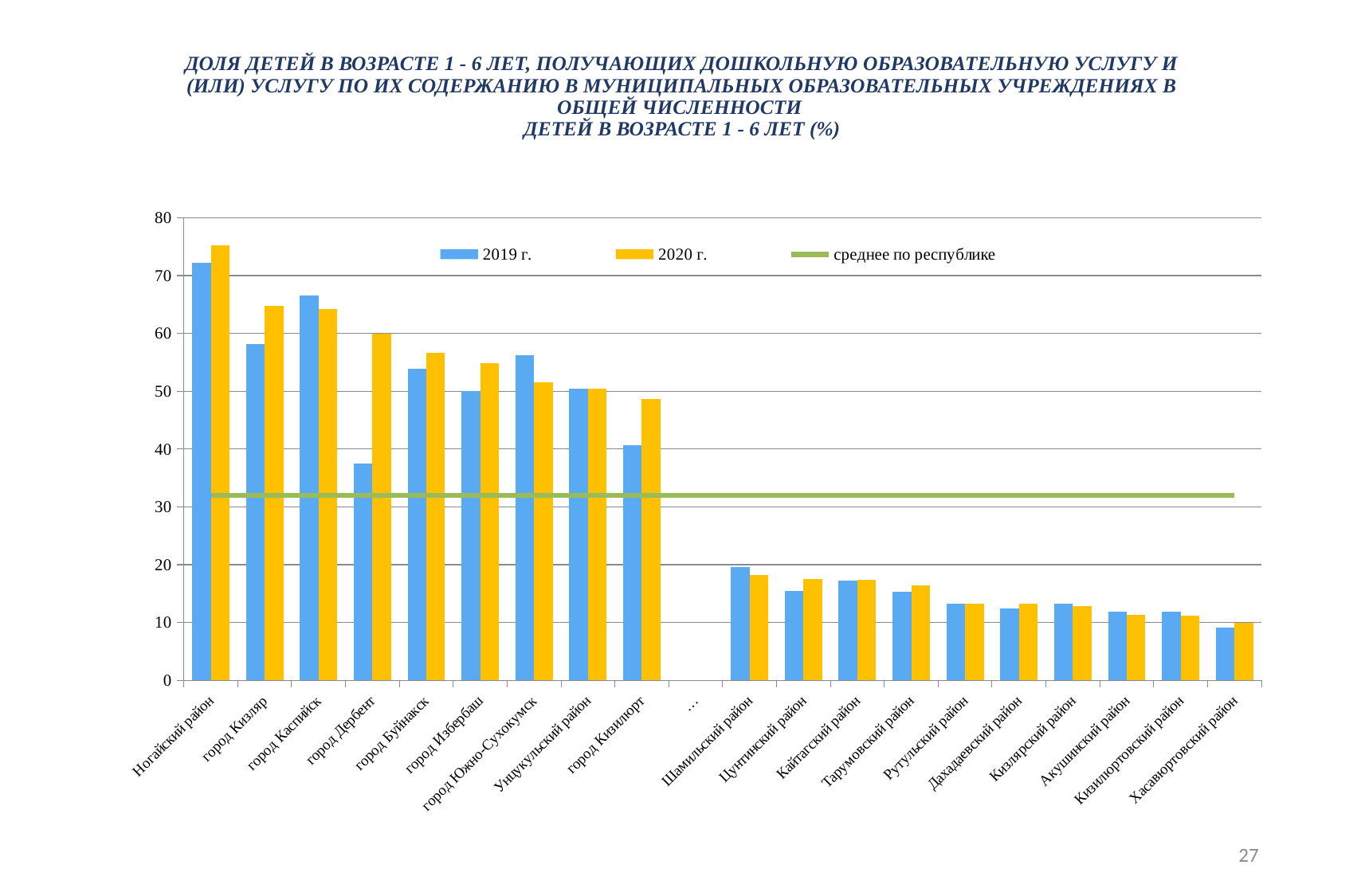
Is the 2020 г. value for Шамильский район greater or less than 20? less Which category has the highest value for 2019 г.? Ногайский район Do the bar values generally rise or fall from left to right along the x axis? fall What does the green horizontal line on the chart represent, according to the legend? среднее по республике Is the 2020 г. value for город Кизилюрт greater or less than 50? less For город Дербент, which is larger: the 2019 г. value or the 2020 г. value? 2020 г. Which category has the lowest value for 2020 г.? Хасавюртовский район For город Южно-Сухокумск, which is larger: the 2019 г. value or the 2020 г. value? 2019 г. Is the 2019 г. value for Ногайский район greater or less than 70? greater What kind of chart is shown on the slide? bar chart How many entries does the chart legend list? 3